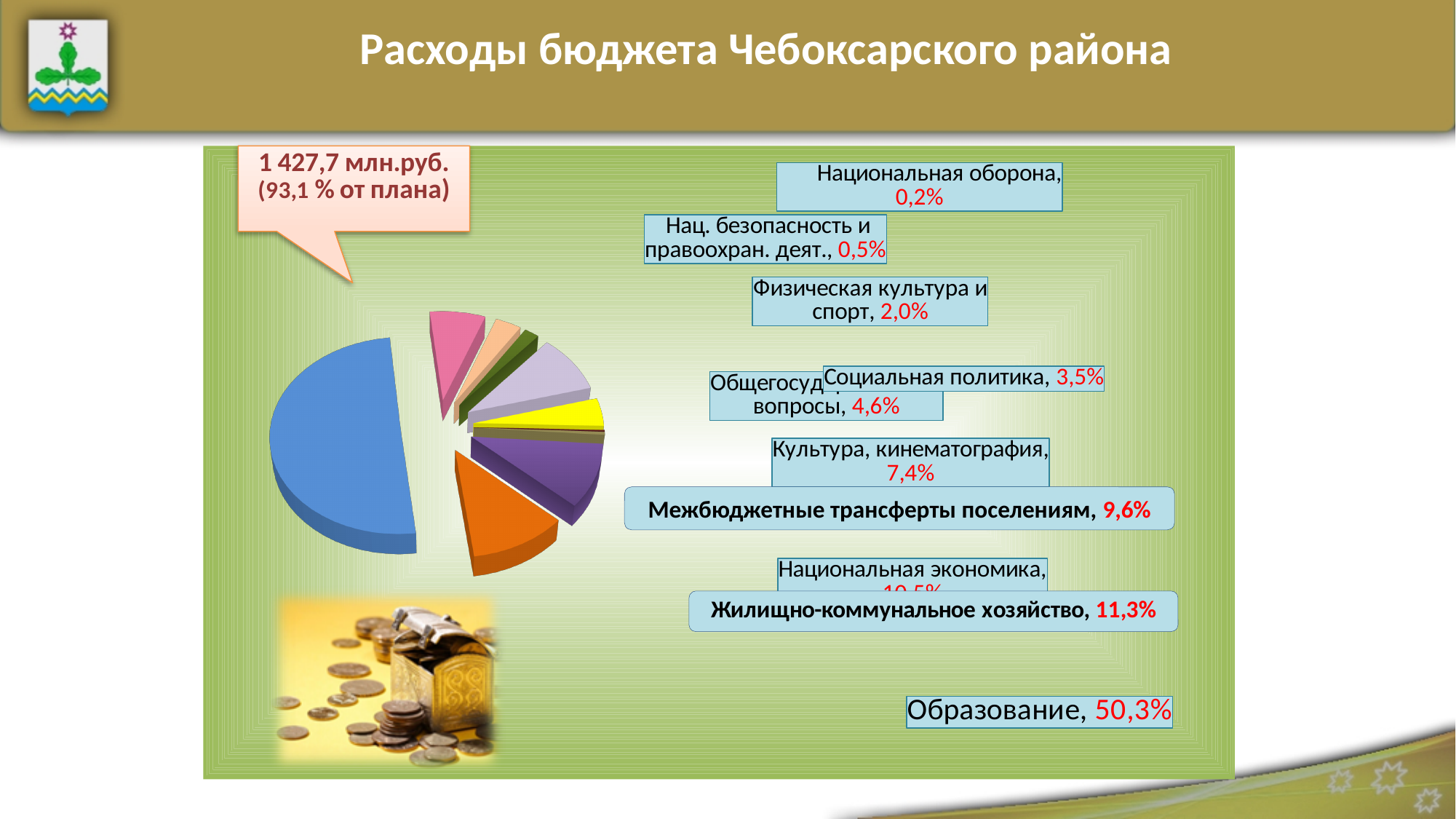
What total expenditure amount is shown in the callout next to the chart? 1 427,7 млн.руб. What is the value for Межбюджетные трансферты поселениям? 9,6% Which is larger, the share for Социальная политика or for Культура, кинематография? Культура, кинематография What is the value for Физическая культура и спорт? 2,0% What is the difference between the shares of Жилищно-коммунальное хозяйство and Межбюджетные трансферты поселениям? 1,7% Which category has the largest share of the pie? Образование Which category has the smallest share of the pie? Национальная оборона What is the value for Культура, кинематография? 7,4% What share of the budget expenditure goes to Образование? 50,3% What is the value for Жилищно-коммунальное хозяйство? 11,3% What kind of chart is shown on the slide? pie chart How many categories are labelled on the pie chart? 10